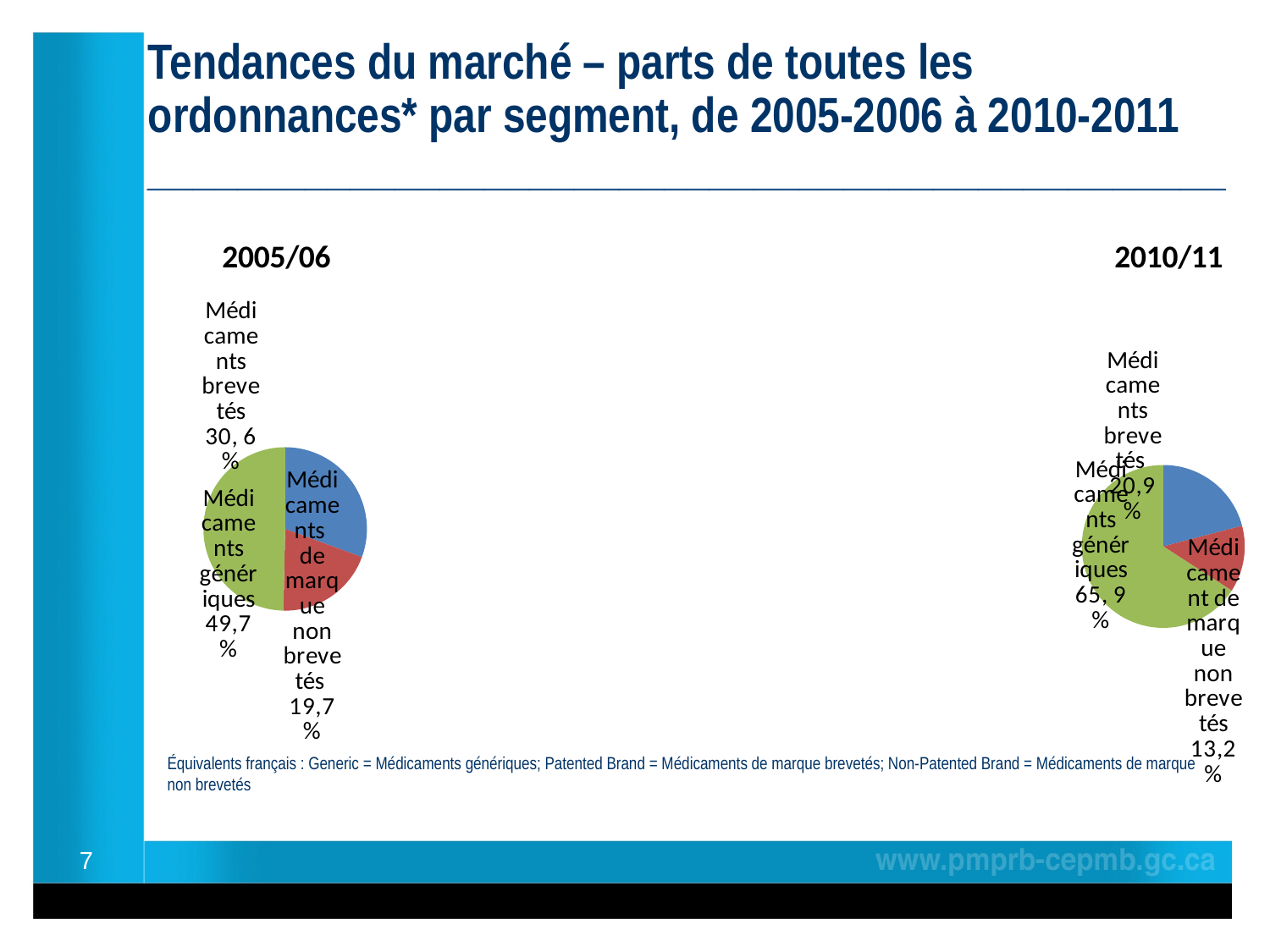
In the 2010/11 pie chart, what share do Médicaments brevetés hold? 20,9 % How many segments does the 2005/06 pie chart contain? 3 In the 2005/06 pie chart, what share do Médicaments génériques hold? 49,7 % In the 2005/06 pie chart, what share do Médicaments de marque non brevetés hold? 19,7 % What type of chart is used for the 2010/11 data? Pie chart In the 2010/11 pie chart, what share do Médicaments de marque non brevetés hold? 13,2 % By how many percentage points did the share of Médicaments génériques change from the 2005/06 chart to the 2010/11 chart? 16,2 points In the 2005/06 pie chart, which segment has the smallest share? Médicaments de marque non brevetés In the 2005/06 pie chart, what share do Médicaments brevetés hold? 30,6 % Is the share of Médicaments brevetés larger in the 2005/06 chart or in the 2010/11 chart? 2005/06 In the 2010/11 pie chart, which segment has the largest share? Médicaments génériques In the 2010/11 pie chart, what share do Médicaments génériques hold? 65,9 %